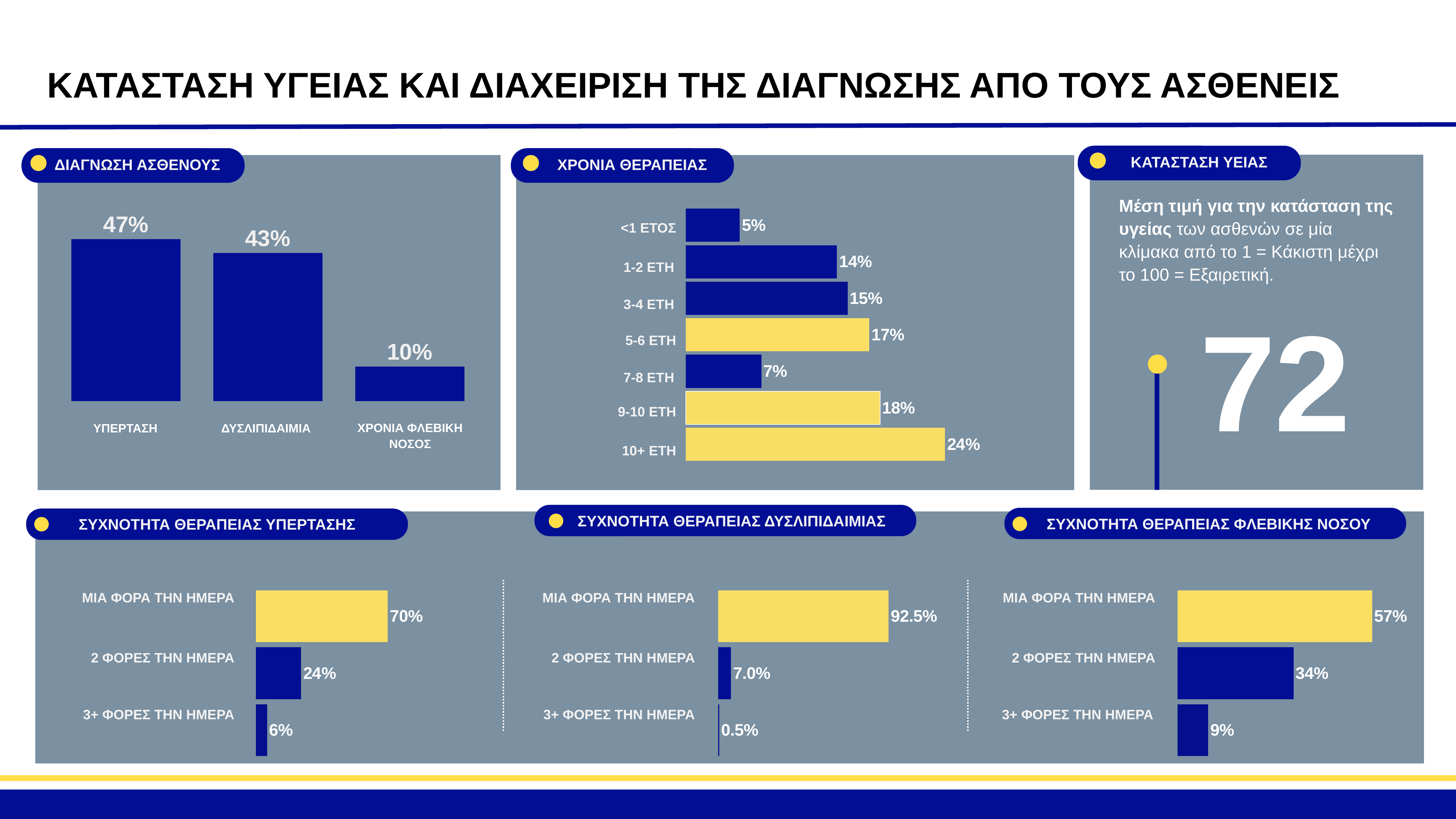
In the ΣΥΧΝΟΤΗΤΑ ΘΕΡΑΠΕΙΑΣ ΦΛΕΒΙΚΗΣ ΝΟΣΟΥ chart, what is the difference between ΜΙΑ ΦΟΡΑ ΤΗΝ ΗΜΕΡΑ and 2 ΦΟΡΕΣ ΤΗΝ ΗΜΕΡΑ? 23% In the ΣΥΧΝΟΤΗΤΑ ΘΕΡΑΠΕΙΑΣ ΔΥΣΛΙΠΙΔΑΙΜΙΑΣ chart, what is the value for ΜΙΑ ΦΟΡΑ ΤΗΝ ΗΜΕΡΑ? 92.5% In the ΔΙΑΓΝΩΣΗ ΑΣΘΕΝΟΥΣ chart, which category has the lowest value? ΧΡΟΝΙΑ ΦΛΕΒΙΚΗ ΝΟΣΟΣ In the ΔΙΑΓΝΩΣΗ ΑΣΘΕΝΟΥΣ chart, what is the value for ΥΠΕΡΤΑΣΗ? 47% In the ΧΡΟΝΙΑ ΘΕΡΑΠΕΙΑΣ chart, what is the value for 5-6 ΕΤΗ? 17% In the ΧΡΟΝΙΑ ΘΕΡΑΠΕΙΑΣ chart, how many categories are shown? 7 In the ΔΙΑΓΝΩΣΗ ΑΣΘΕΝΟΥΣ chart, what is the difference between ΥΠΕΡΤΑΣΗ and ΔΥΣΛΙΠΙΔΑΙΜΙΑ? 4% What kind of chart is the ΧΡΟΝΙΑ ΘΕΡΑΠΕΙΑΣ chart? Bar chart In the ΣΥΧΝΟΤΗΤΑ ΘΕΡΑΠΕΙΑΣ ΥΠΕΡΤΑΣΗΣ chart, what is the value for 2 ΦΟΡΕΣ ΤΗΝ ΗΜΕΡΑ? 24% In the ΧΡΟΝΙΑ ΘΕΡΑΠΕΙΑΣ chart, which is larger: 1-2 ΕΤΗ or 7-8 ΕΤΗ? 1-2 ΕΤΗ In the ΧΡΟΝΙΑ ΘΕΡΑΠΕΙΑΣ chart, which category has the highest value? 10+ ΕΤΗ In the ΣΥΧΝΟΤΗΤΑ ΘΕΡΑΠΕΙΑΣ ΔΥΣΛΙΠΙΔΑΙΜΙΑΣ chart, which category has the lowest value? 3+ ΦΟΡΕΣ ΤΗΝ ΗΜΕΡΑ